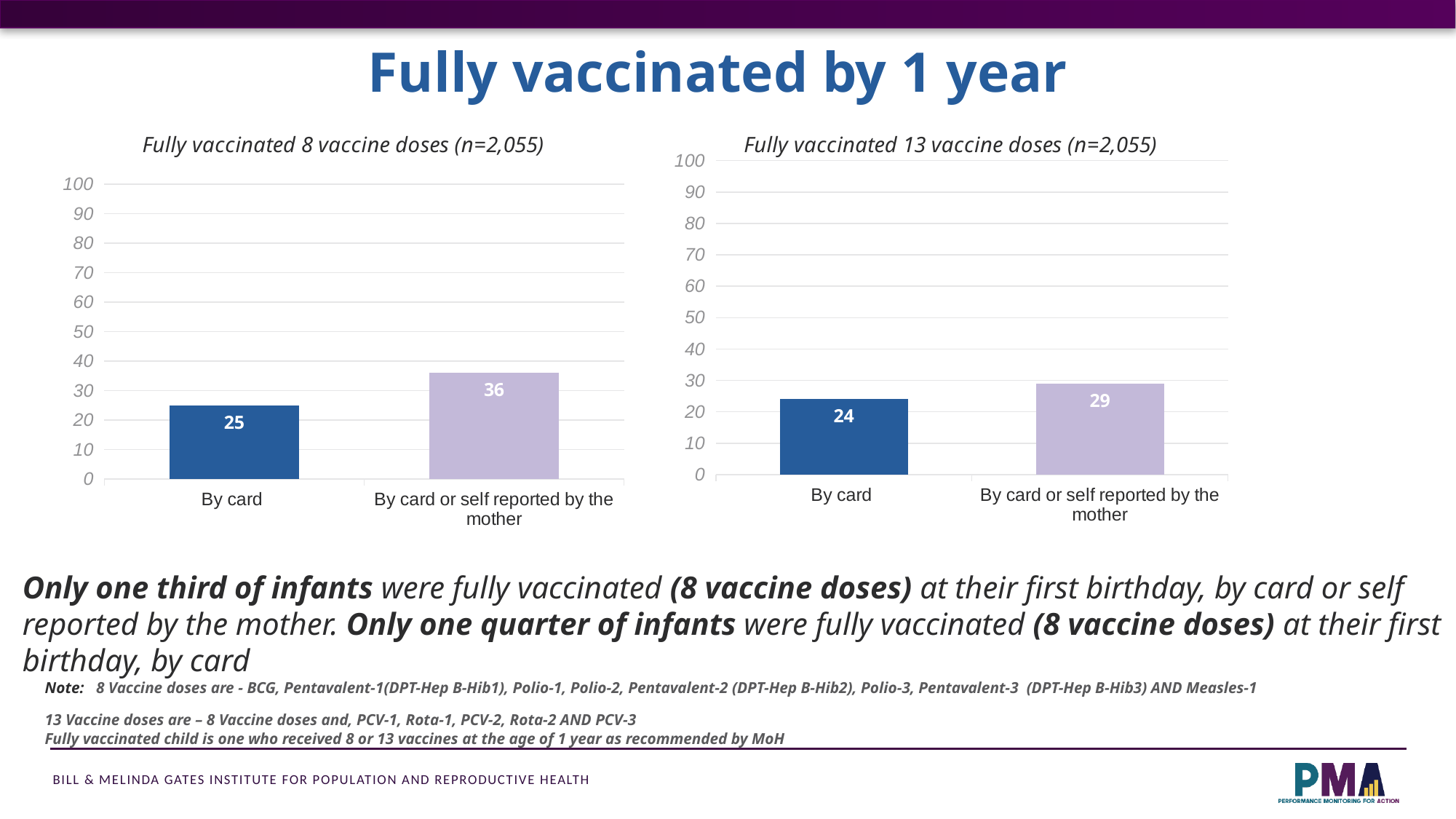
In the 'Fully vaccinated 8 vaccine doses (n=2,055)' chart, what is the difference between 'By card or self reported by the mother' and 'By card'? 11 In the 'Fully vaccinated 8 vaccine doses (n=2,055)' chart, what is the value for 'By card or self reported by the mother'? 36 What kind of chart is the 'Fully vaccinated 13 vaccine doses (n=2,055)' chart? Bar chart In the 'Fully vaccinated 13 vaccine doses (n=2,055)' chart, what is the value for 'By card'? 24 In the 'Fully vaccinated 13 vaccine doses (n=2,055)' chart, which category has the lowest value? By card In the 'Fully vaccinated 13 vaccine doses (n=2,055)' chart, what is the value for 'By card or self reported by the mother'? 29 In the 'Fully vaccinated 8 vaccine doses (n=2,055)' chart, which category has the highest value? By card or self reported by the mother Is the 'By card' value in the 'Fully vaccinated 8 vaccine doses (n=2,055)' chart larger or smaller than the 'By card' value in the 'Fully vaccinated 13 vaccine doses (n=2,055)' chart? larger In the 'Fully vaccinated 8 vaccine doses (n=2,055)' chart, what is the value for 'By card'? 25 In the 'Fully vaccinated 13 vaccine doses (n=2,055)' chart, what is the difference between 'By card or self reported by the mother' and 'By card'? 5 How many categories are shown in the 'Fully vaccinated 8 vaccine doses (n=2,055)' chart? 2 In the 'Fully vaccinated 13 vaccine doses (n=2,055)' chart, is the value for 'By card or self reported by the mother' greater or less than 40? less